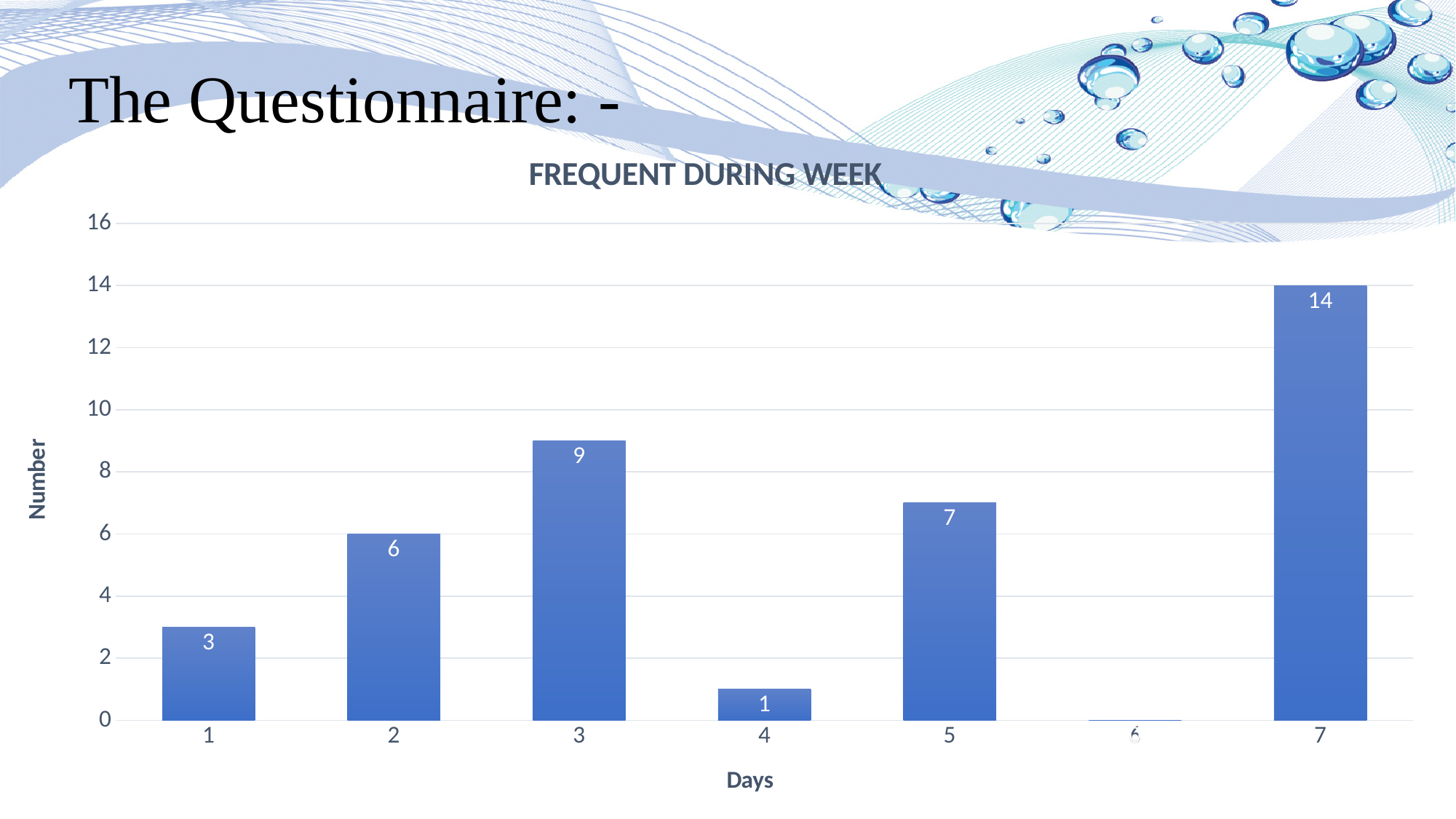
Is the value for day 3 greater or less than 8? greater Which day has the highest value? 7 What is the title of the chart? FREQUENT DURING WEEK What is the value for day 7? 14 Which is larger, the value for day 2 or the value for day 5? day 5 What is the value for day 3? 9 What is the difference between the values for day 5 and day 1? 4 What is the value for day 4? 1 What kind of chart is shown? bar chart How many days are shown on the x axis? 7 What is the value for day 2? 6 What is the difference between the values for day 7 and day 3? 5